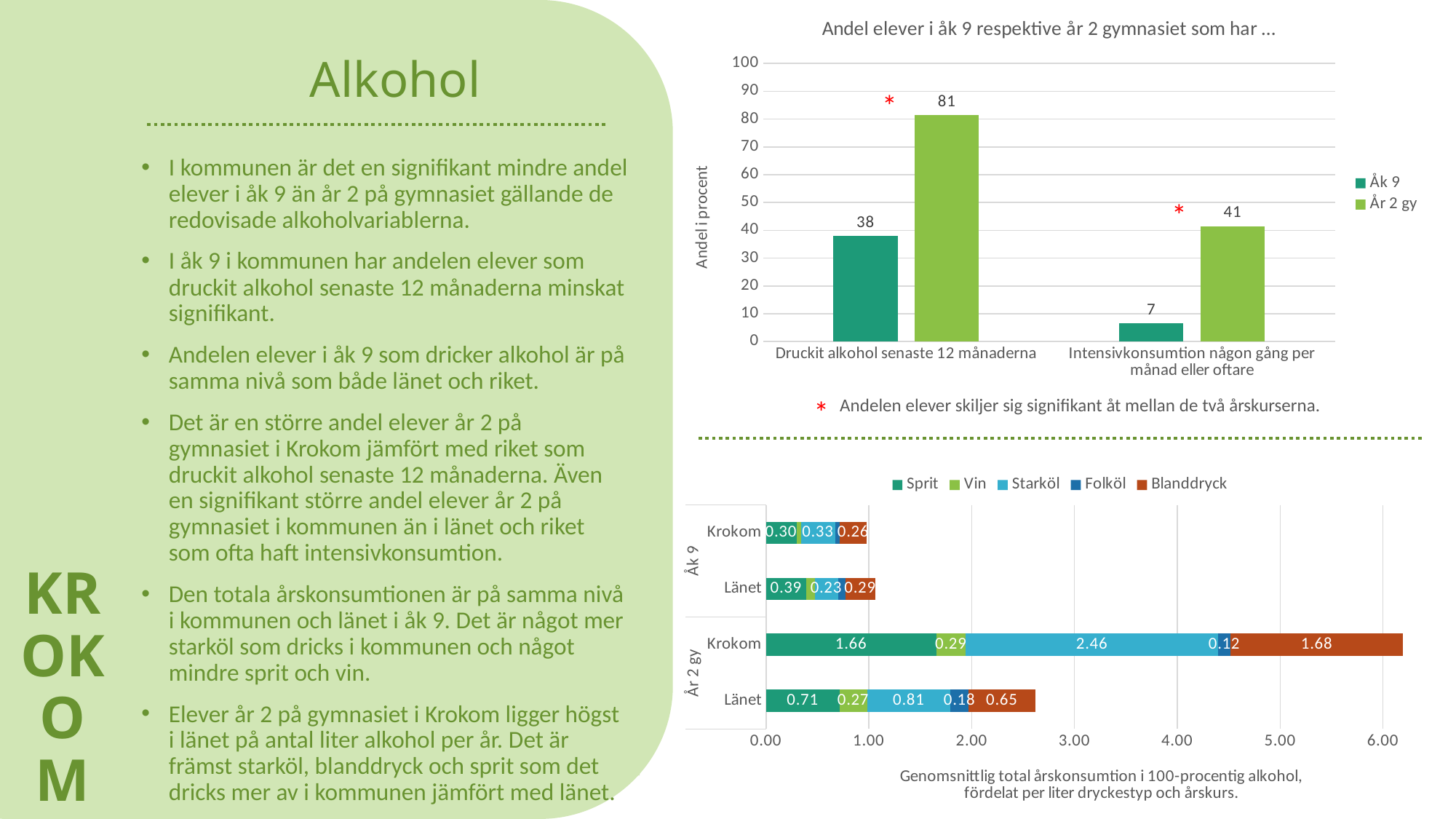
In the top chart, what is the value for Åk 9 for 'Druckit alkohol senaste 12 månaderna'? 38 In the bottom chart, what is the Starköl value for Krokom in År 2 gy? 2.46 In the bottom chart, how many series does the legend list? 5 In the bottom chart, what is the total for Krokom in År 2 gy? 6.21 In the bottom chart, which is larger: the Sprit value for Krokom in Åk 9 or the Sprit value for Länet in Åk 9? Länet What kind of chart is the bottom chart? Stacked bar chart In the top chart, what is the value for År 2 gy for 'Intensivkonsumtion någon gång per månad eller oftare'? 41 In the top chart, what is the difference between År 2 gy and Åk 9 for 'Druckit alkohol senaste 12 månaderna'? 43 In the top chart, which series has the lowest value overall? Åk 9 In the top chart, is the Åk 9 value for 'Intensivkonsumtion någon gång per månad eller oftare' greater or less than 10? less In the bottom chart, what is the total for Länet in År 2 gy? 2.62 In the top chart, how many series does the legend list? 2